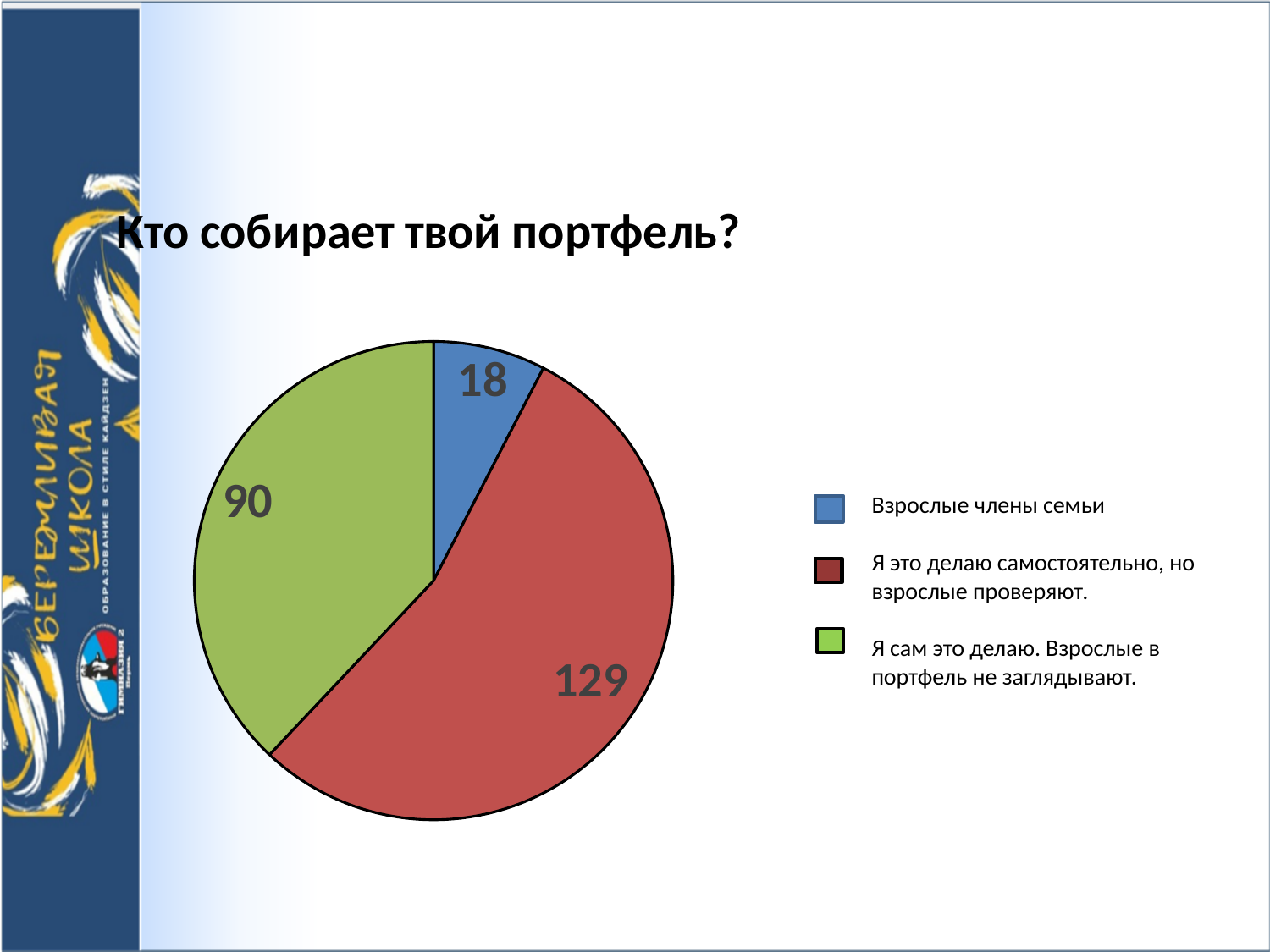
What colour is the slice for "Взрослые члены семьи"? blue What is the value for "Я это делаю самостоятельно, но взрослые проверяют"? 129 How many slices does the pie chart have? 3 What is the value for "Я сам это делаю. Взрослые в портфель не заглядывают"? 90 What type of chart is shown on the slide? pie chart What is the difference between the values for "Я это делаю самостоятельно, но взрослые проверяют" and "Я сам это делаю. Взрослые в портфель не заглядывают"? 39 How many entries does the legend list? 3 Which category has the largest slice? Я это делаю самостоятельно, но взрослые проверяют What is the title of the chart? Кто собирает твой портфель? Which is larger: the value for "Я сам это делаю. Взрослые в портфель не заглядывают" or the value for "Взрослые члены семьи"? Я сам это делаю. Взрослые в портфель не заглядывают What is the value for "Взрослые члены семьи"? 18 Which category has the smallest slice? Взрослые члены семьи